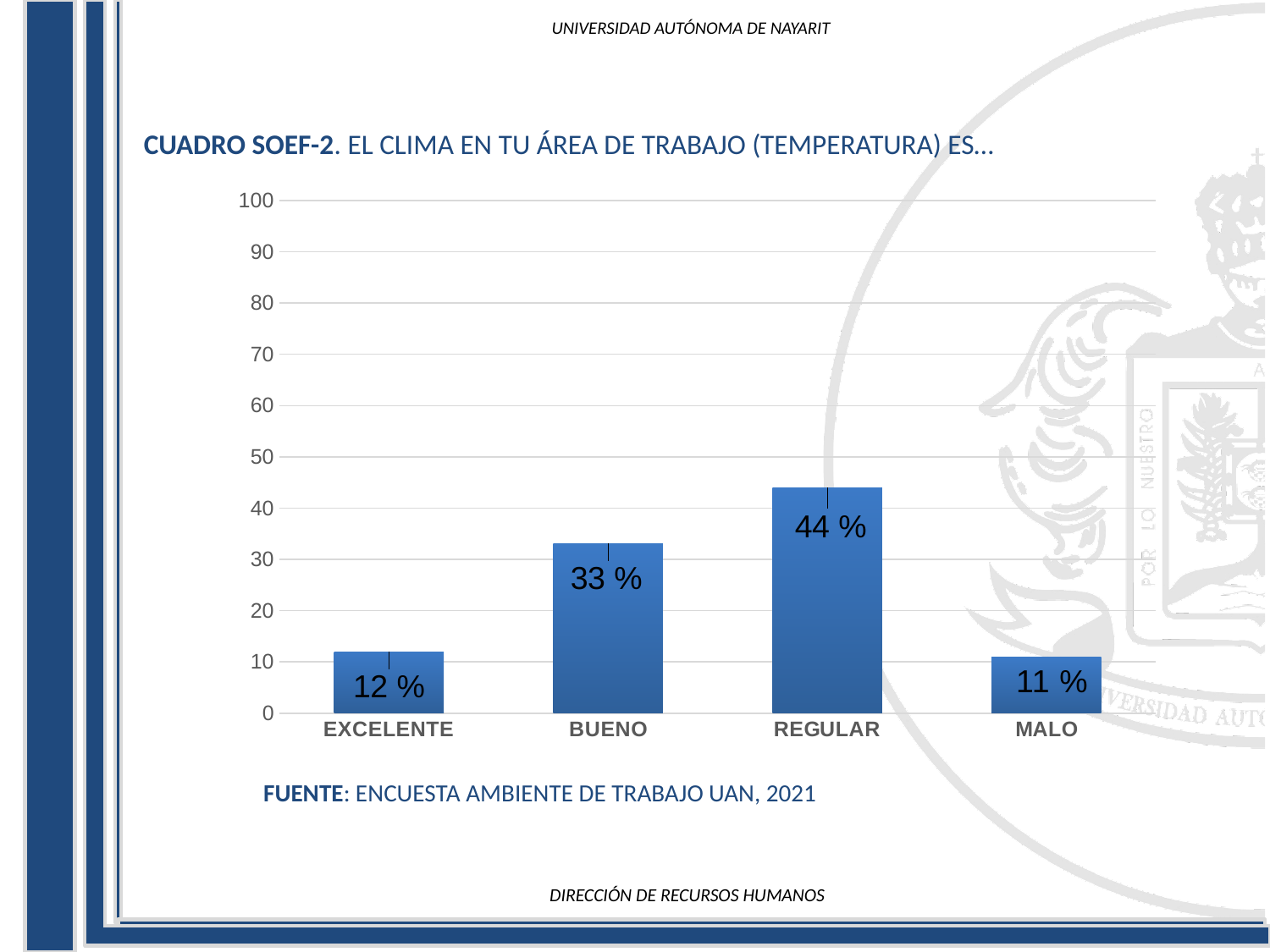
Is the value for REGULAR greater or less than 50? less Which category has the highest value? REGULAR What is the value for REGULAR? 44 % What is the value for MALO? 11 % What is the value for EXCELENTE? 12 % What is the value for BUENO? 33 % What is the source cited below the chart? ENCUESTA AMBIENTE DE TRABAJO UAN, 2021 How many categories are shown on the x axis? 4 Which category has the lowest value? MALO What is the difference between the values for REGULAR and BUENO? 11 % Which is larger, the value for BUENO or the value for EXCELENTE? BUENO What kind of chart is shown on the slide? bar chart